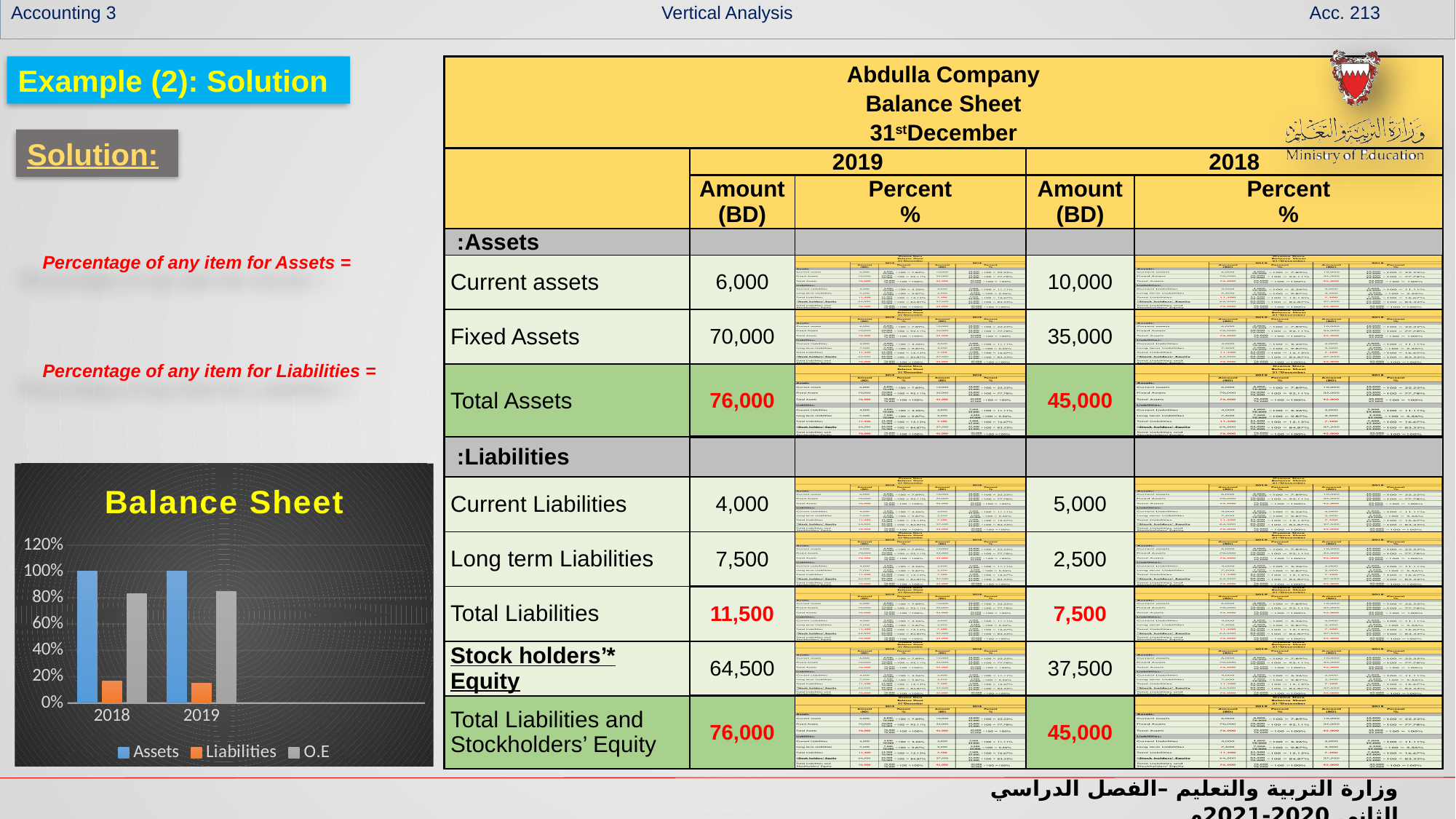
In the Balance Sheet chart, which is larger in 2019: Assets or Liabilities? Assets In the Balance Sheet chart, is the value for Liabilities in 2018 greater or less than 20%? less How many series does the legend of the Balance Sheet chart list? 3 In the Balance Sheet chart, which series has the highest value in 2018? Assets What is the title of the chart on the slide? Balance Sheet Which series are listed in the legend of the Balance Sheet chart? Assets, Liabilities, O.E In the Balance Sheet chart, does the Assets value rise, fall or stay the same from 2018 to 2019? stays the same What kind of chart is the Balance Sheet chart on the slide? bar chart In the Balance Sheet chart, which series has the lowest value in 2019? Liabilities How many years (categories) are shown on the x axis of the Balance Sheet chart? 2 In the Balance Sheet chart, what is the value of Assets for 2018? 100% In the Balance Sheet chart, is the value for O.E in 2019 greater or less than 60%? greater